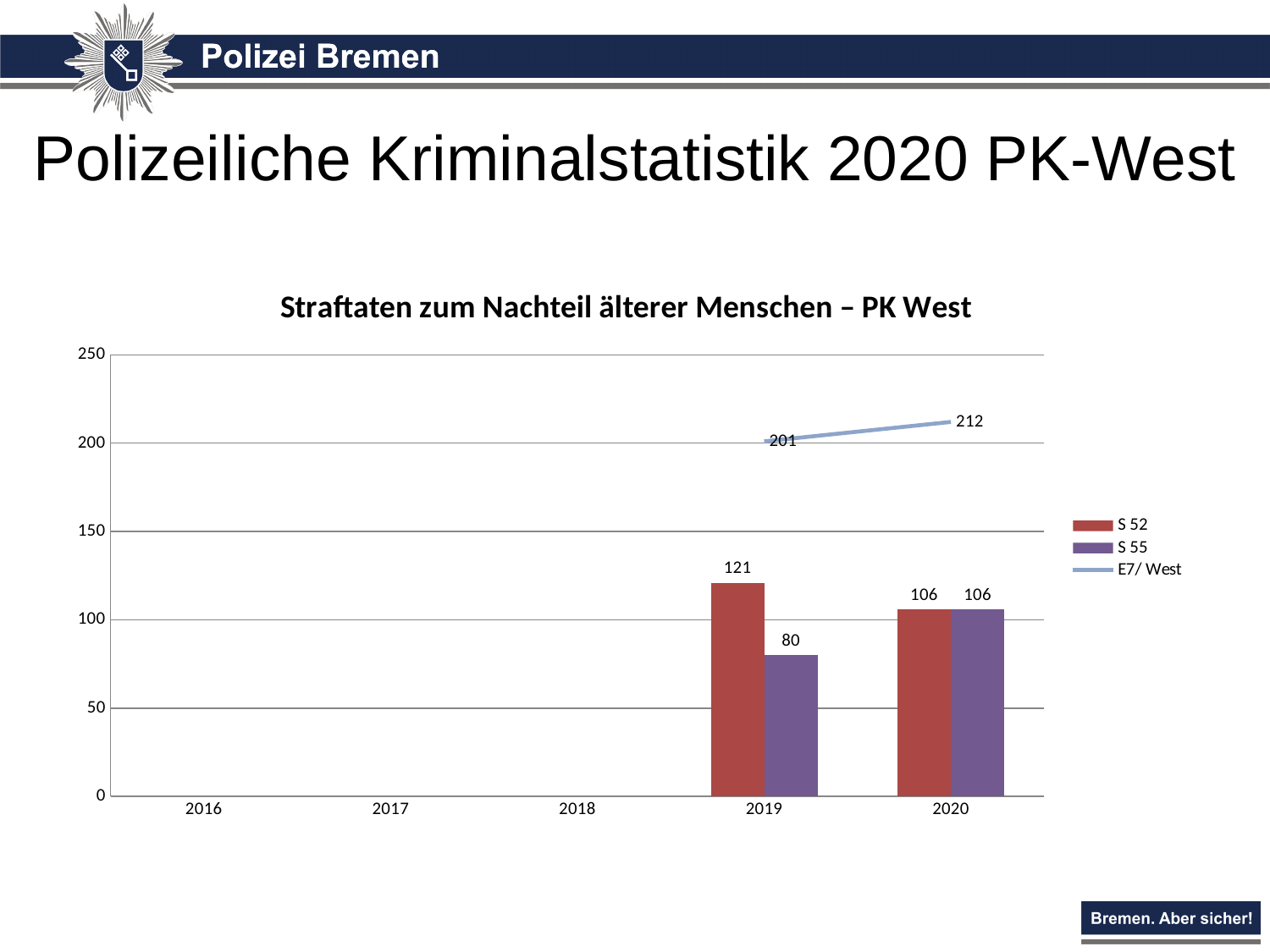
By how much did E7/ West change from 2019 to 2020? 11 How many years are shown on the x axis? 5 What is the title of the chart? Straftaten zum Nachteil älterer Menschen – PK West Which is larger in 2019, S 52 or S 55? S 52 What is the value of S 52 in 2019? 121 What is the value of S 52 in 2020? 106 What is the value of E7/ West in 2020? 212 What is the difference between S 52 and S 55 in 2019? 41 Does the E7/ West line rise or fall from 2019 to 2020? rise What is the value of E7/ West in 2019? 201 How many series does the legend list? 3 What is the value of S 55 in 2019? 80